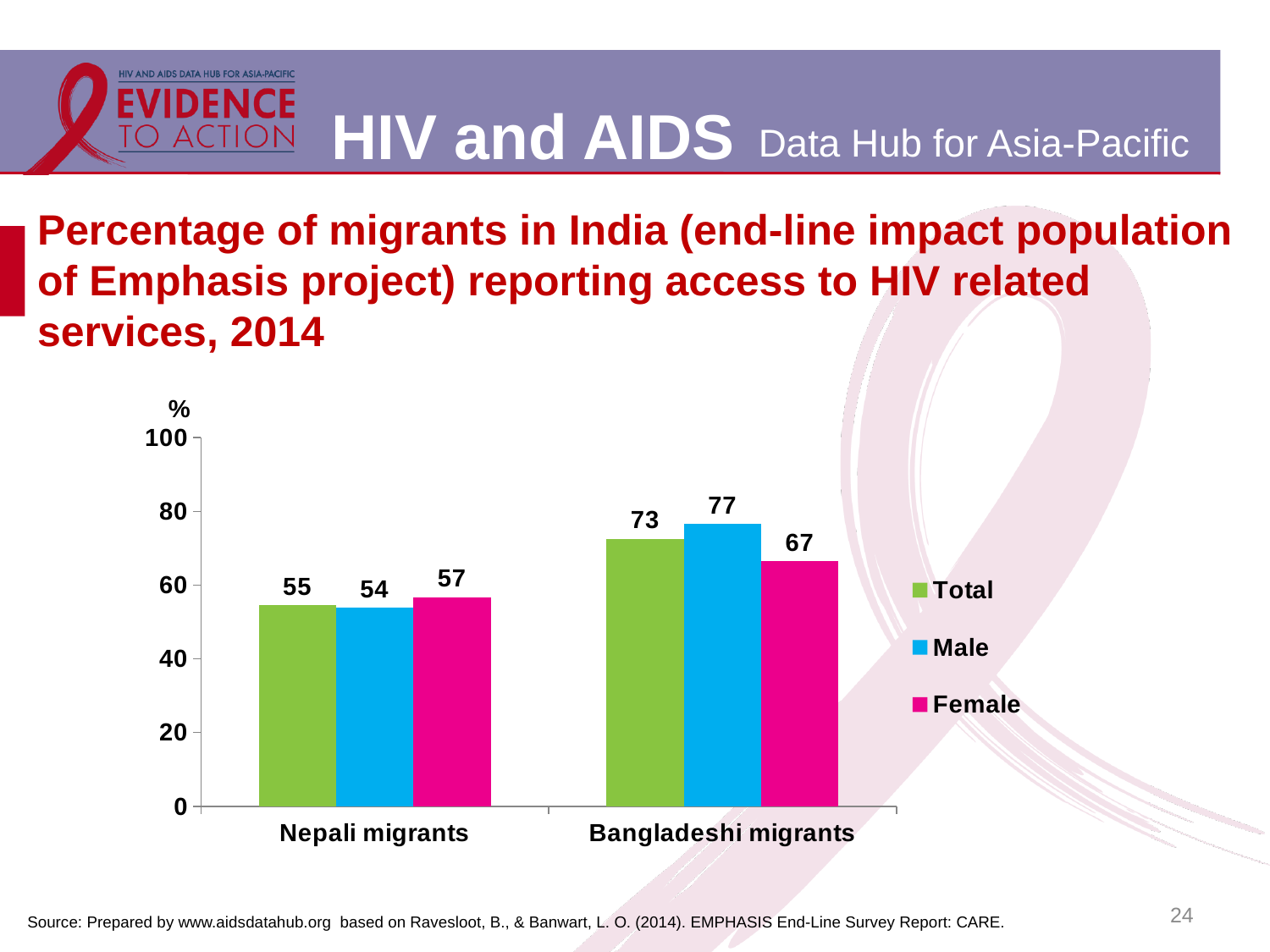
What is the Male value for Bangladeshi migrants? 77 What kind of chart is shown on the slide? Bar chart Which series has the highest value for Bangladeshi migrants? Male Which series has the lowest value for Nepali migrants? Male Which is larger, the Total value for Nepali migrants or the Total value for Bangladeshi migrants? Bangladeshi migrants How many migrant groups are shown on the x axis? 2 What is the Female value for Nepali migrants? 57 How many series does the legend list? 3 What is the difference between the Male values for Bangladeshi migrants and Nepali migrants? 23 What is the Total value for Nepali migrants? 55 What is the Female value for Bangladeshi migrants? 67 Is the Female value for Bangladeshi migrants greater or less than 60? greater